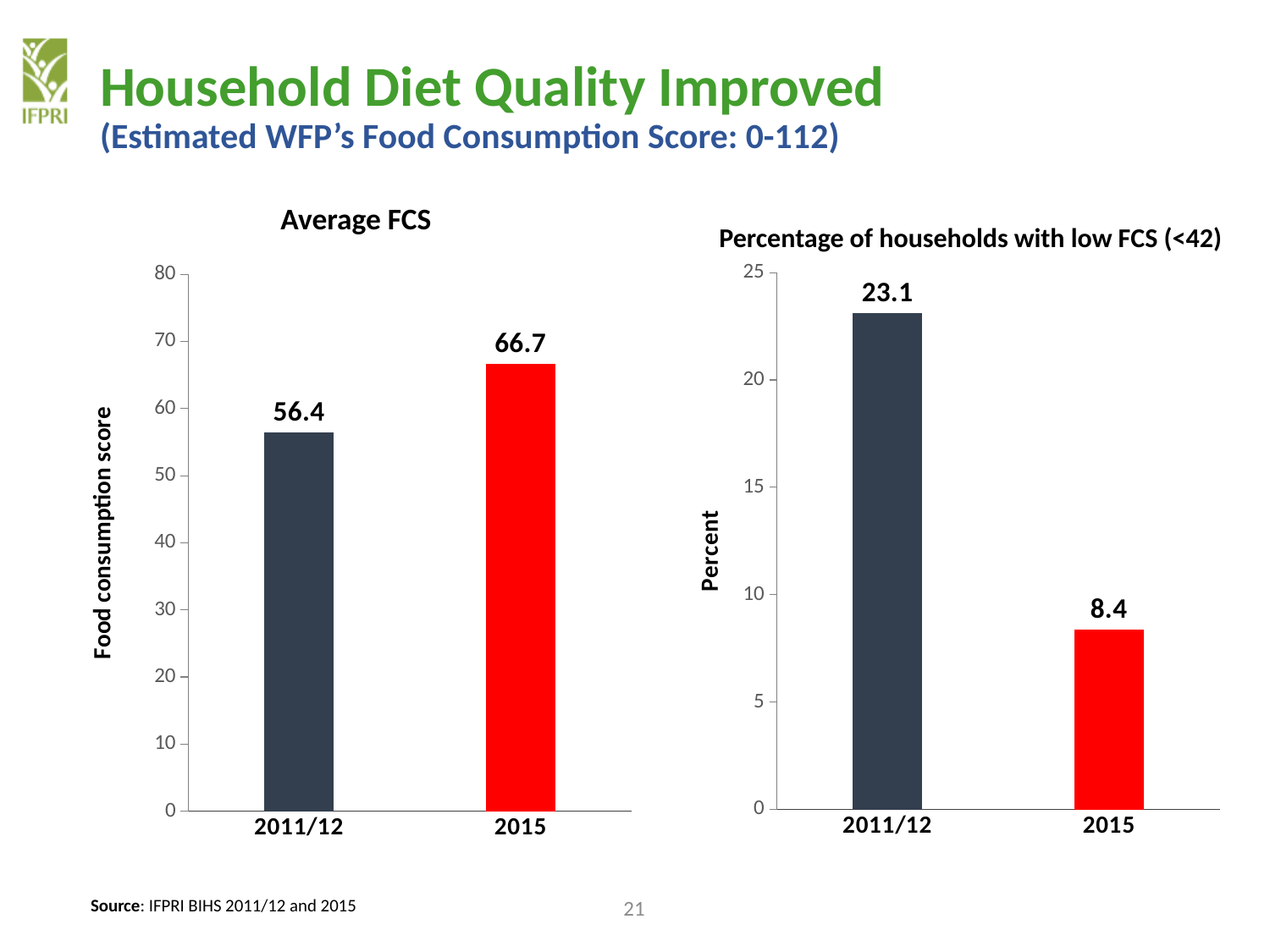
In the 'Average FCS' chart, what is the value for 2011/12? 56.4 In the 'Percentage of households with low FCS (<42)' chart, what is the value for 2015? 8.4 In the 'Average FCS' chart, what is the value for 2015? 66.7 In the 'Average FCS' chart, what is the difference between the 2015 and 2011/12 values? 10.3 How many categories are shown on the x axis of the 'Average FCS' chart? 2 In the 'Percentage of households with low FCS (<42)' chart, what is the value for 2011/12? 23.1 What kind of chart is the 'Percentage of households with low FCS (<42)' chart? bar chart In the 'Percentage of households with low FCS (<42)' chart, is the value for 2011/12 greater or less than 20? greater In the 'Percentage of households with low FCS (<42)' chart, which year has the lowest value? 2015 What is the y-axis label of the 'Average FCS' chart? Food consumption score In the 'Percentage of households with low FCS (<42)' chart, what is the difference between the 2011/12 and 2015 values? 14.7 In the 'Average FCS' chart, which year has the higher value? 2015